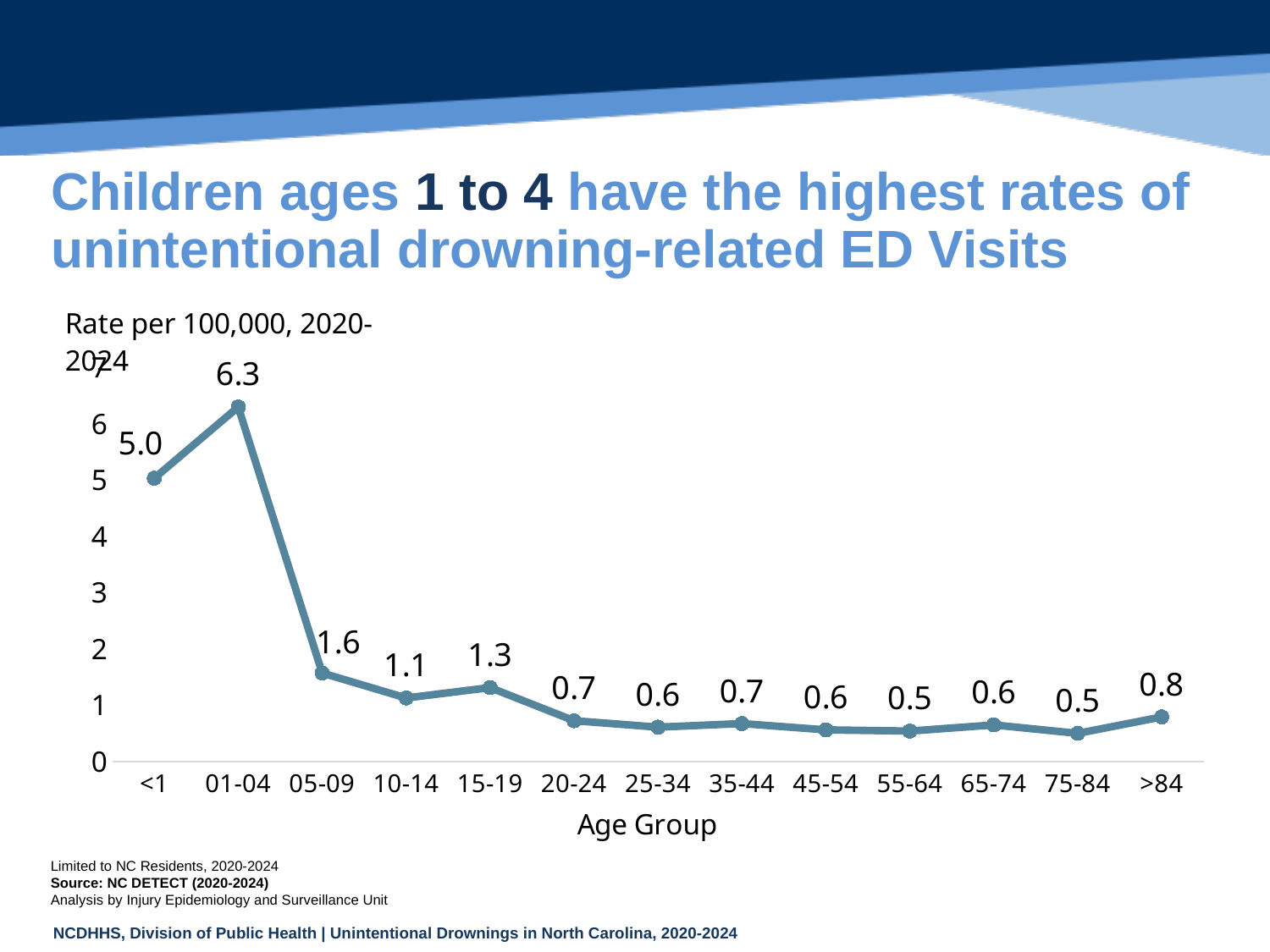
What is the rate per 100,000 for the 01-04 age group? 6.3 Which age group has the highest rate? 01-04 What is the difference between the rates for the 05-09 and 10-14 age groups? 0.5 What is the rate per 100,000 for the >84 age group? 0.8 Is the value for the 01-04 age group greater or less than 6? greater What is the rate per 100,000 for the <1 age group? 5.0 What is the difference between the rates for the 01-04 and <1 age groups? 1.3 What kind of chart is shown on the slide? Line chart How many age groups are plotted on the chart? 13 What is the label of the x axis? Age Group What is the rate per 100,000 for the 15-19 age group? 1.3 Which has a higher rate, the 05-09 age group or the 15-19 age group? 05-09